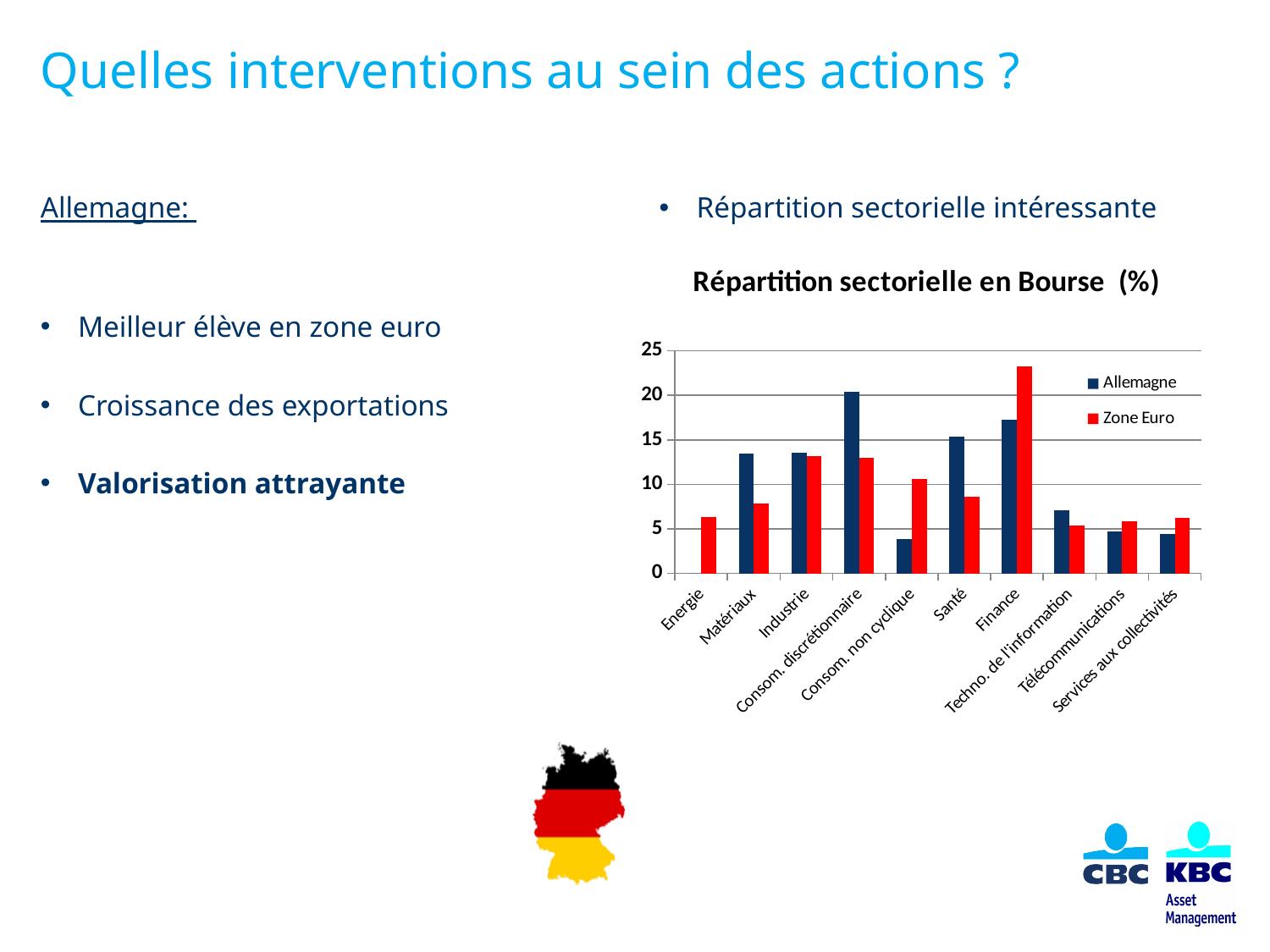
Which sector has the highest value for the Allemagne series? Consom. discrétionnaire Which colour represents the Zone Euro series in the chart? red Which sector has the highest value for the Zone Euro series? Finance What kind of chart is shown under the title 'Répartition sectorielle en Bourse (%)'? bar chart For Finance, which series has the larger value, Allemagne or Zone Euro? Zone Euro Is the Allemagne value for Finance greater or less than 20? less Is the Allemagne value for Consom. non cyclique greater or less than 5? less How many sector categories are shown on the x axis of the chart? 10 For Santé, which series has the larger value, Allemagne or Zone Euro? Allemagne Is the Zone Euro value for Matériaux greater or less than 10? less How many series does the legend of the chart list? 2